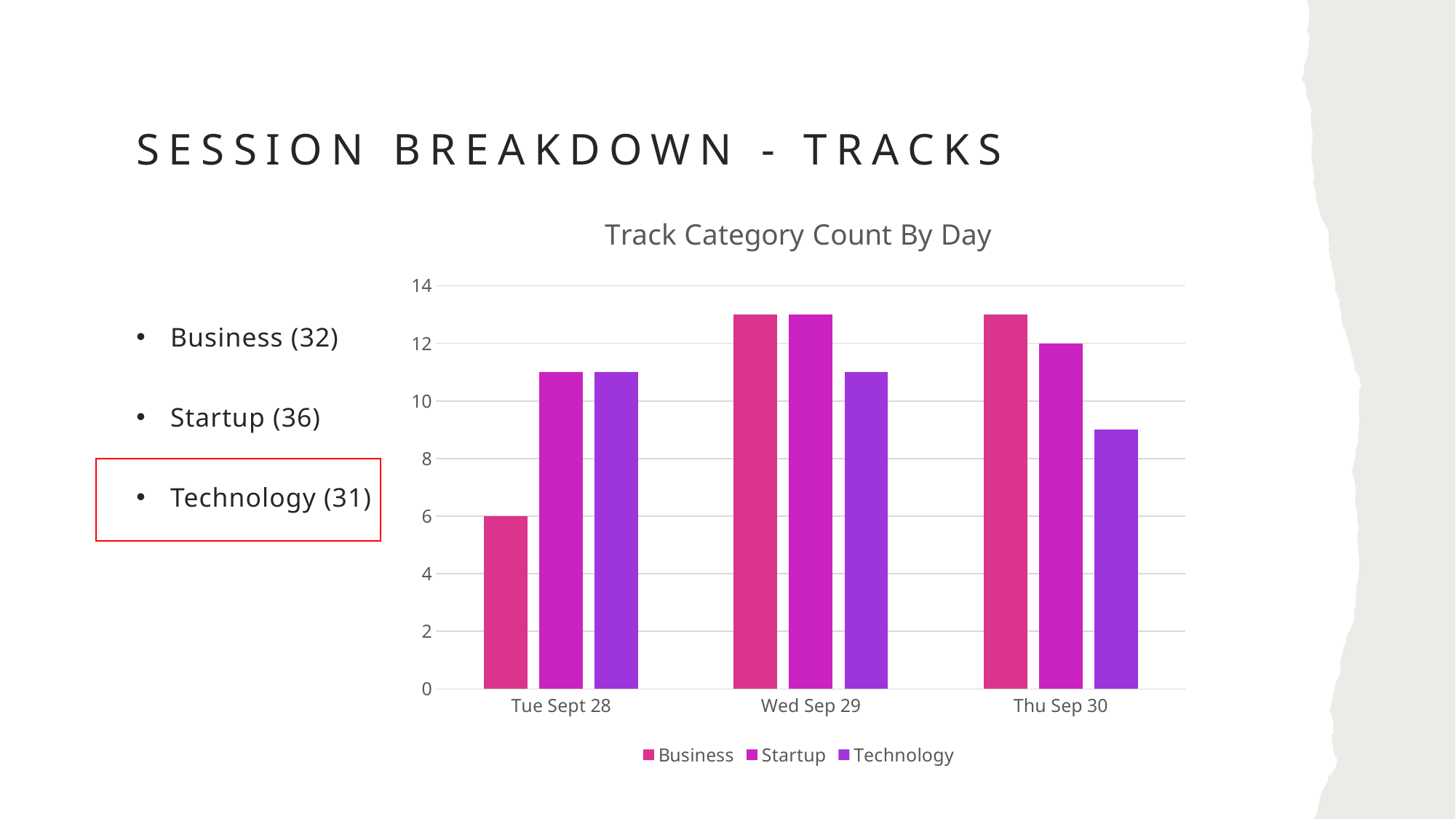
What is the Business value for Tue Sept 28? 6 Which is larger on Thu Sep 30, the Business value or the Technology value? Business Is the Startup value for Tue Sept 28 greater or less than 10? greater What is the title of the chart? Track Category Count By Day How many days are shown on the x axis of the chart? 3 Which day has the lowest Business value? Tue Sept 28 What is the Startup value for Thu Sep 30? 12 Is the Technology value for Thu Sep 30 greater or less than 10? less Is the Business value for Wed Sep 29 greater or less than 12? greater How many series does the chart legend list? 3 What kind of chart is shown on the slide? bar chart Which day has the lowest Technology value? Thu Sep 30